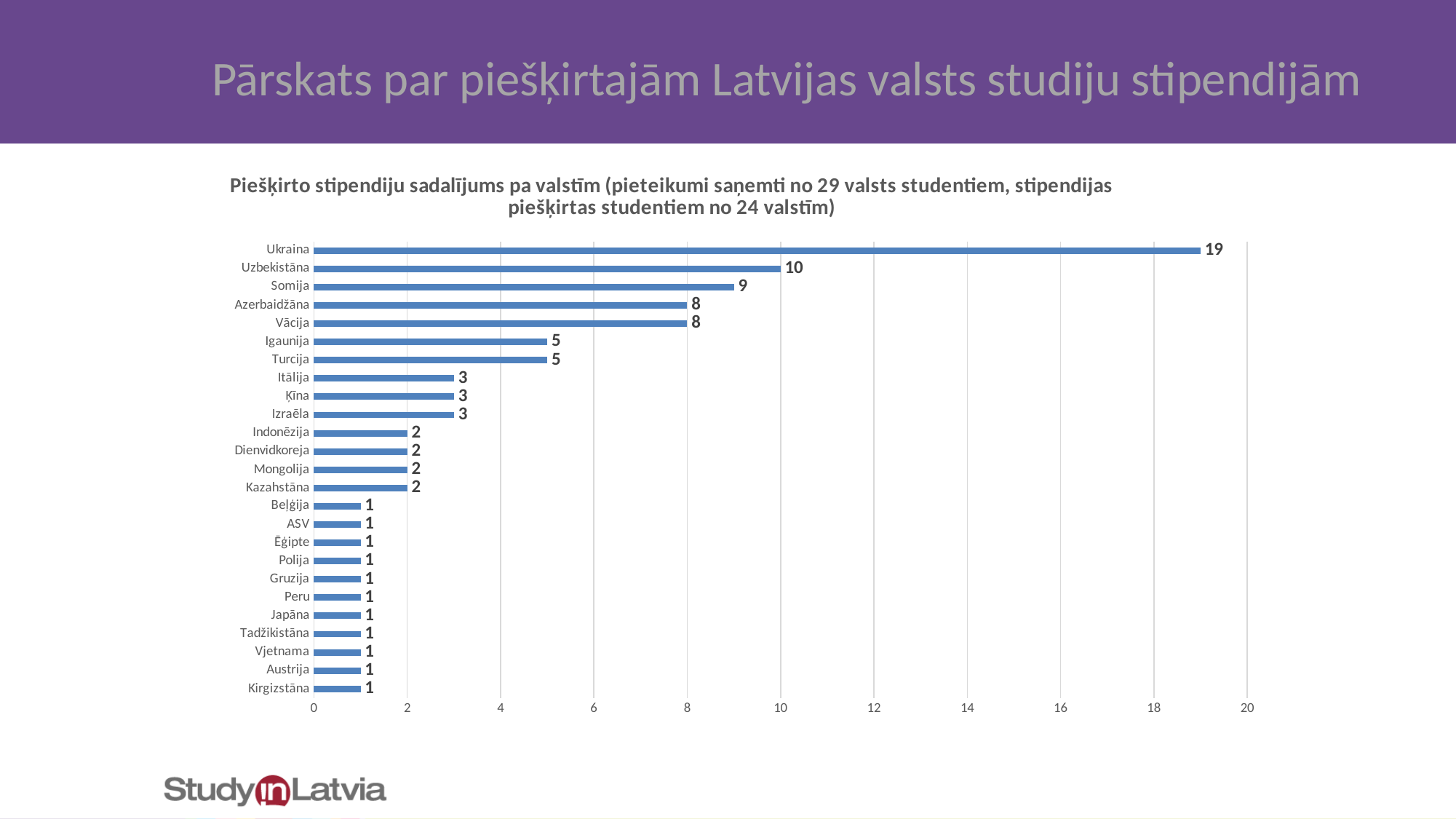
Which has a larger value, Somija or Vācija? Somija What type of chart is shown on the slide? Bar chart What is the difference between the values for Ukraina and Uzbekistāna? 9 How many countries are listed in the chart? 25 What is the value shown for Turcija? 5 Which country has the highest number of scholarships in the chart? Ukraina What is the value shown for Somija? 9 What is the value shown for Kirgizstāna? 1 Which has a larger value, Igaunija or Ķīna? Igaunija What is the difference between the values for Azerbaidžāna and Itālija? 5 Is the value for Uzbekistāna greater or less than 8? greater How many scholarships were awarded to students from Ukraina? 19